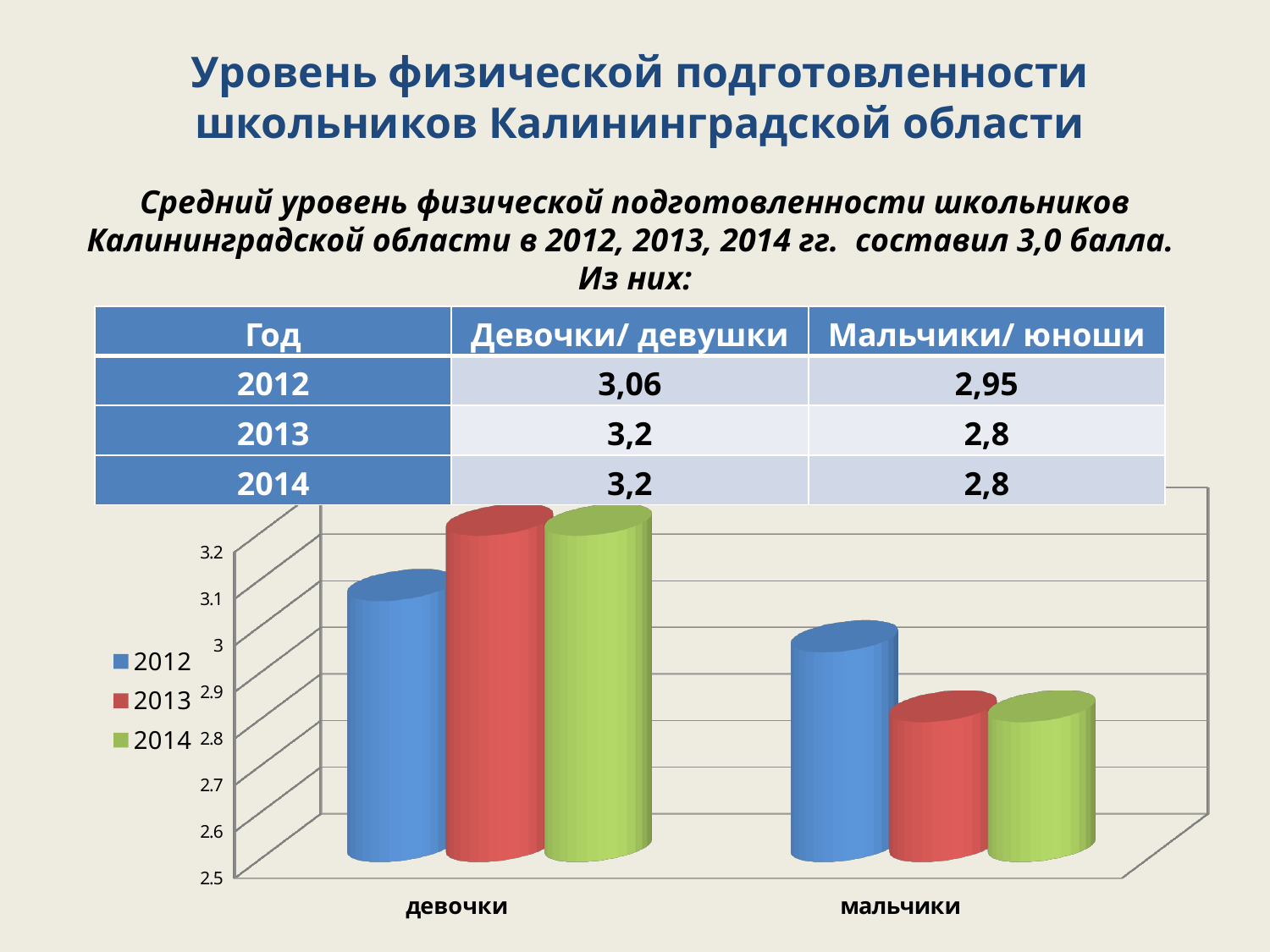
What kind of chart is shown on the slide? bar chart In 2012, which category has the larger value, девочки or мальчики? девочки What is the value for мальчики in 2013? 2,8 How many series does the chart legend list? 3 What is the value for девочки in 2012? 3,06 What is the difference between the values for девочки and мальчики in 2012? 0,11 Is the value for мальчики in 2014 greater or less than 3? less For девочки, which year has the lowest value? 2012 Is the value for девочки in 2013 greater or less than 3? greater Do the values for мальчики rise or fall from 2012 to 2013? fall For мальчики, which year has the highest value? 2012 How many categories are shown on the x axis of the chart? 2